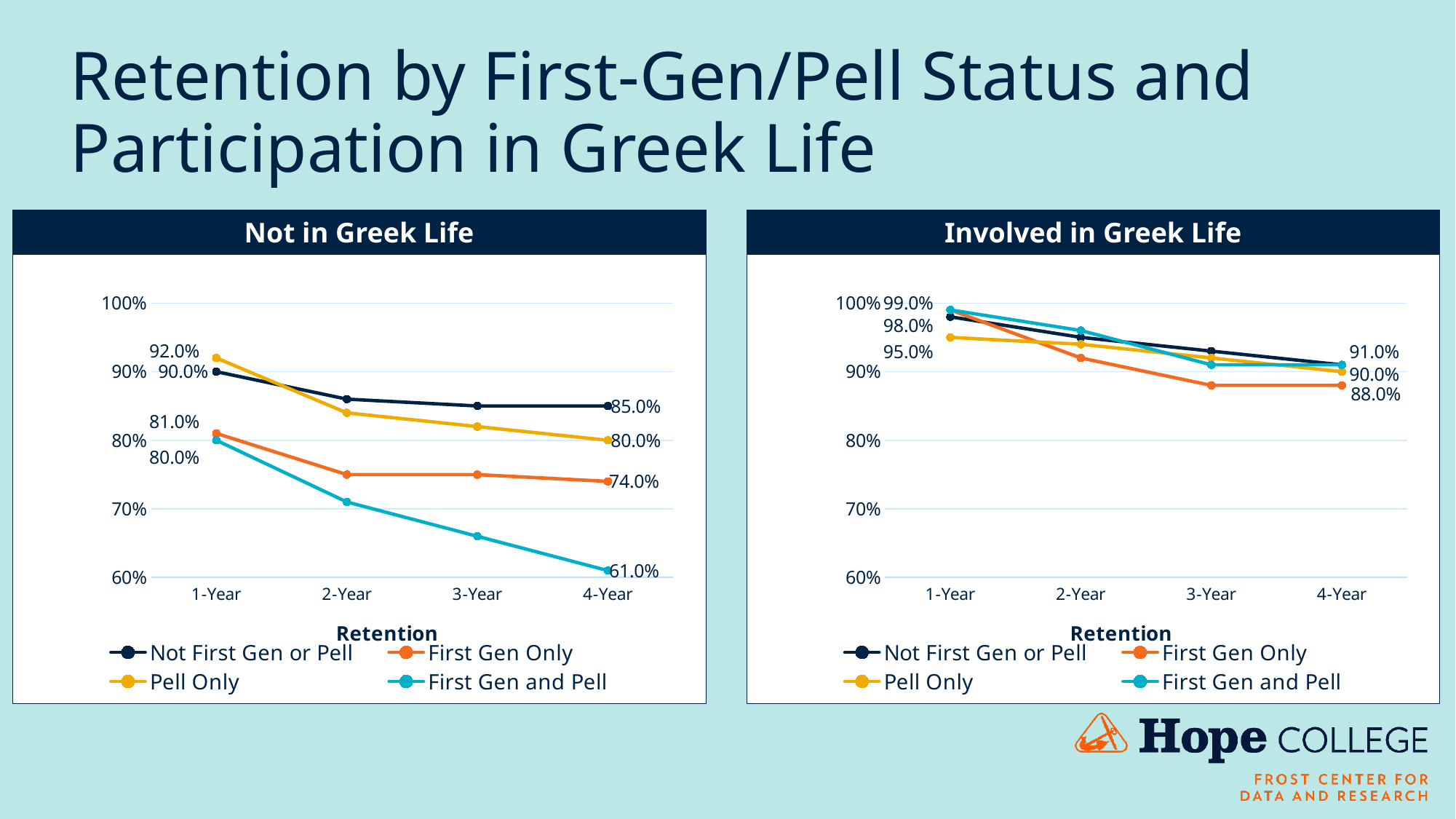
In the 'Not in Greek Life' chart, does the retention for First Gen and Pell rise or fall from 1-Year to 4-Year? Fall In the 'Involved in Greek Life' chart, what is the 4-Year retention for First Gen Only? 88.0% In the 'Not in Greek Life' chart, what is the 1-Year retention for Pell Only? 92.0% In the 'Not in Greek Life' chart, which is larger: the 4-Year retention for Pell Only or for First Gen Only? Pell Only In the 'Not in Greek Life' chart, what is the 4-Year retention for First Gen Only? 74.0% In the 'Not in Greek Life' chart, what is the 4-Year retention for First Gen and Pell? 61.0% What kind of chart is the 'Not in Greek Life' chart? Line chart In the 'Not in Greek Life' chart, which group has the lowest 4-Year retention? First Gen and Pell In the 'Involved in Greek Life' chart, what is the 1-Year retention for Pell Only? 95.0% In the 'Not in Greek Life' chart, is the 3-Year retention for First Gen and Pell greater or less than 70%? less In the 'Not in Greek Life' chart, what is the difference between the 4-Year retention of Not First Gen or Pell and First Gen and Pell? 24.0 percentage points How many series does the legend of the 'Involved in Greek Life' chart list? 4